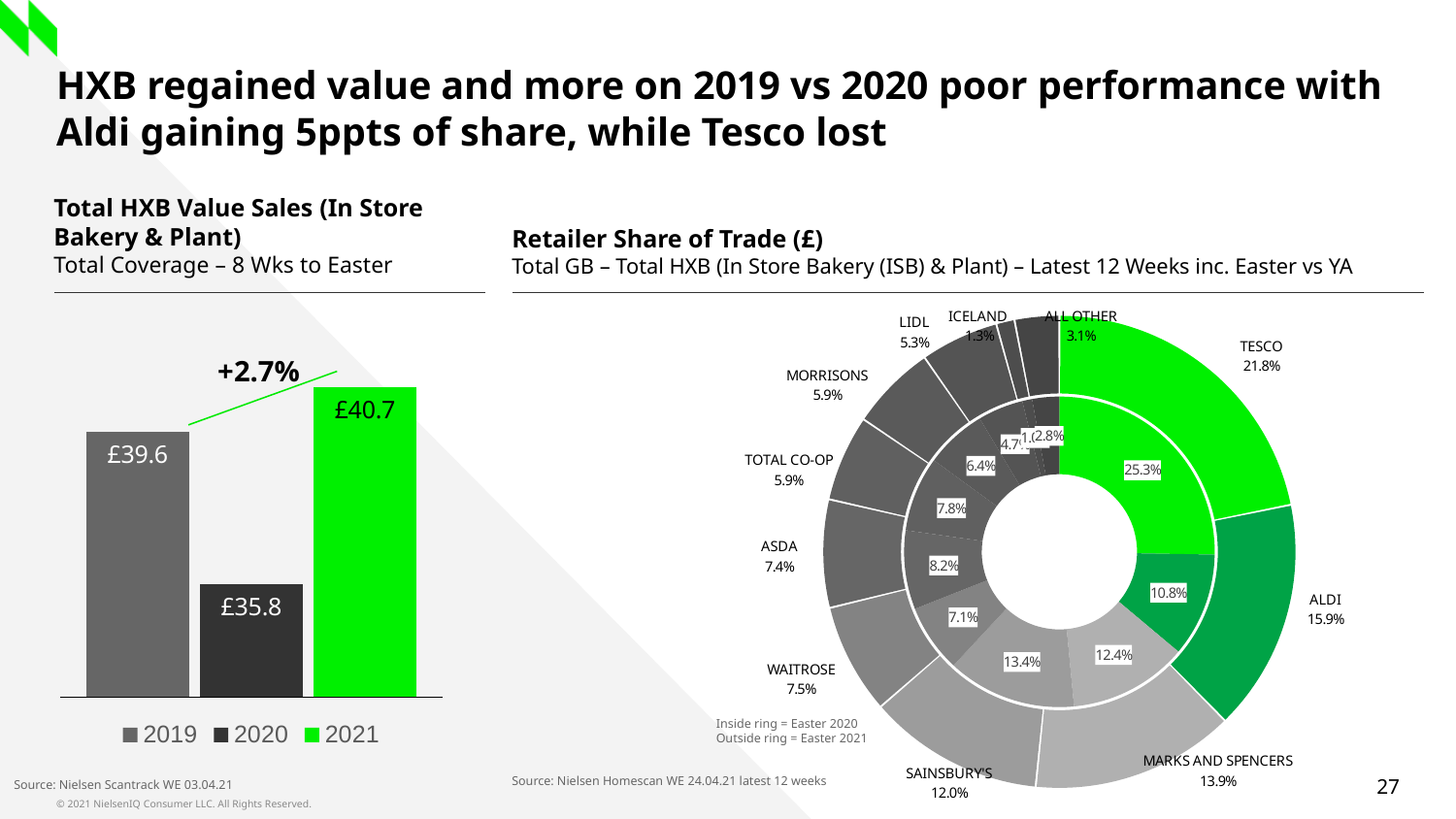
On the Retailer Share of Trade chart, which retailer has the largest share in the outside ring (Easter 2021)? Tesco On the Total HXB Value Sales bar chart, what is the difference between the 2021 and 2019 values? £1.1 On the Retailer Share of Trade chart, what is Tesco's share in the outside ring (Easter 2021)? 21.8% On the Retailer Share of Trade chart, which is larger in the outside ring: Sainsbury's or Marks and Spencers? Marks and Spencers On the Retailer Share of Trade chart, what does the inside ring represent? Easter 2020 On the Total HXB Value Sales bar chart, what is the value for 2021? £40.7 On the Total HXB Value Sales bar chart, how many years does the legend list? 3 What kind of chart is the Total HXB Value Sales chart? Bar chart On the Total HXB Value Sales bar chart, which year has the lowest value? 2020 On the Total HXB Value Sales bar chart, what is the value for 2020? £35.8 On the Retailer Share of Trade chart, what is Aldi's share in the inside ring (Easter 2020)? 10.8% On the Retailer Share of Trade chart, which retailer has the smallest share in the outside ring (Easter 2021)? Iceland